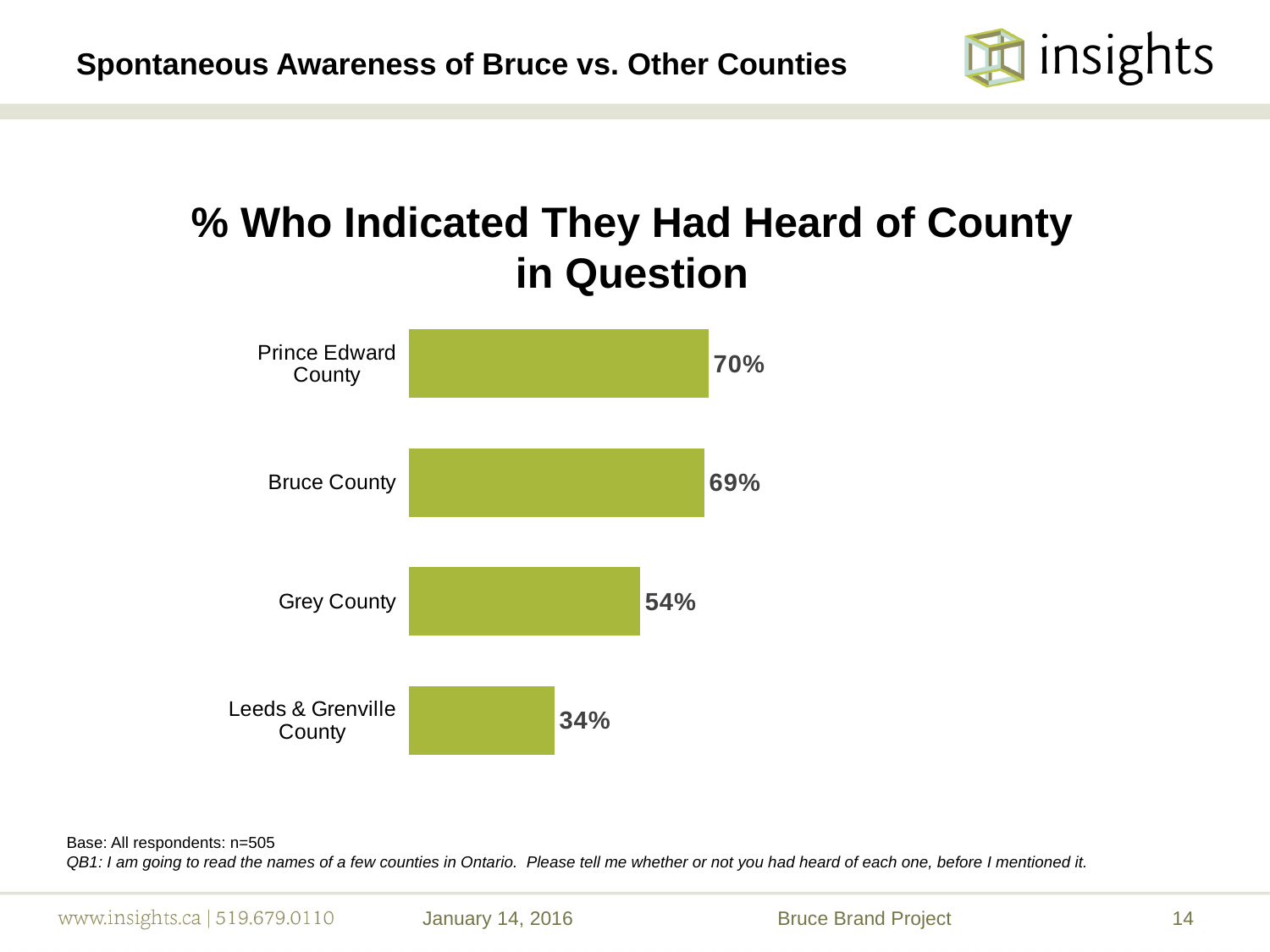
Which has a higher awareness percentage, Grey County or Leeds & Grenville County? Grey County What percentage of respondents indicated they had heard of Prince Edward County? 70% What is the difference in awareness between Bruce County and Grey County? 15 percentage points What is the title of the chart? % Who Indicated They Had Heard of County in Question What is the difference in awareness between Prince Edward County and Leeds & Grenville County? 36 percentage points Which county has the lowest awareness percentage? Leeds & Grenville County How many counties are shown in the chart? 4 What percentage of respondents indicated they had heard of Bruce County? 69% Which county has the highest awareness percentage? Prince Edward County What percentage of respondents indicated they had heard of Grey County? 54% What type of chart is shown on the slide? Bar chart What percentage of respondents indicated they had heard of Leeds & Grenville County? 34%